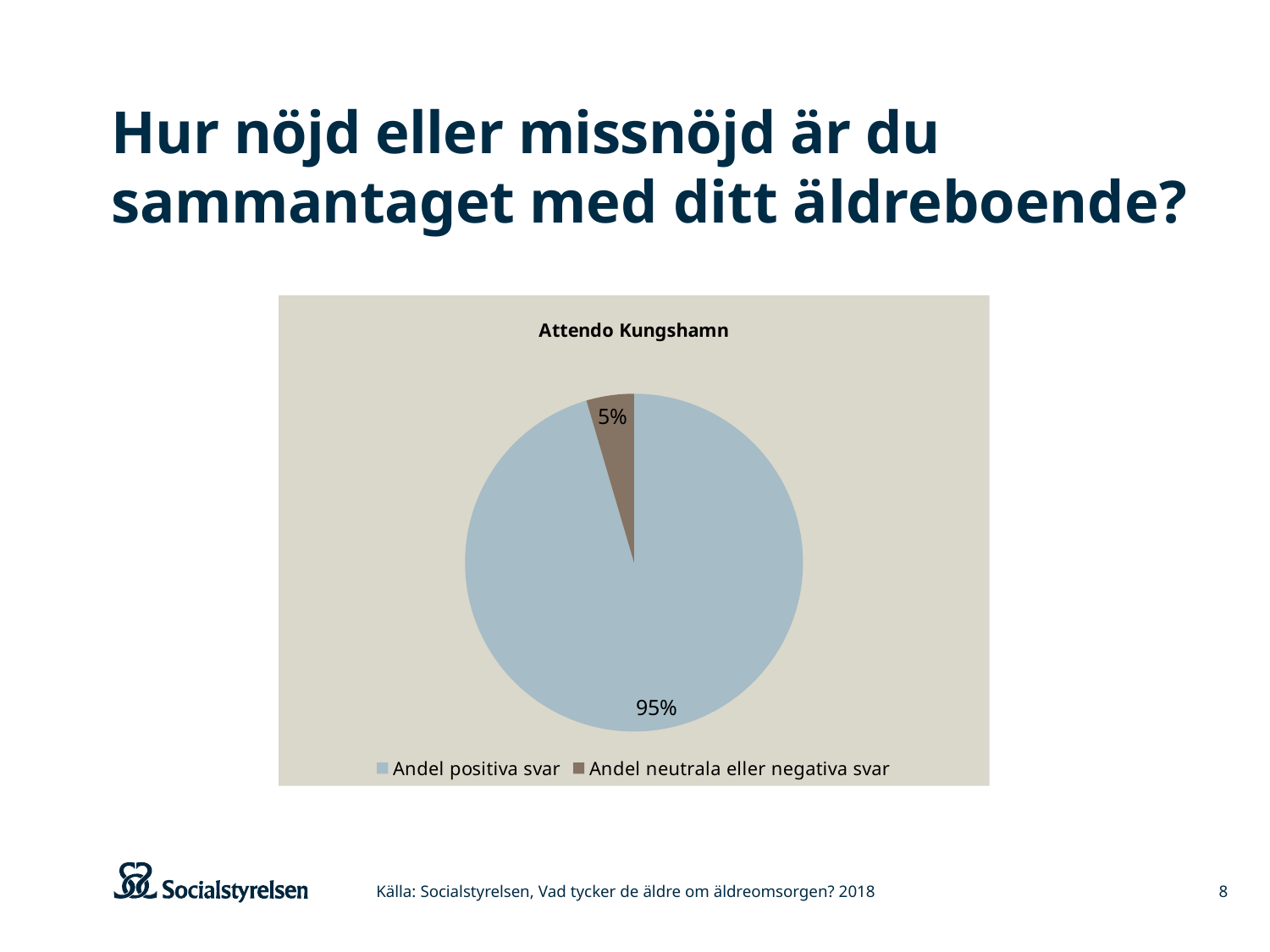
What share of the pie is 'Andel positiva svar'? 95% Which slice is the smallest in the pie chart? Andel neutrala eller negativa svar How many slices does the pie chart have? 2 What colour is the 'Andel neutrala eller negativa svar' slice? Brown What is the difference between the 'Andel positiva svar' share and the 'Andel neutrala eller negativa svar' share? 90% Which slice is the largest in the pie chart? Andel positiva svar What share of the pie is 'Andel neutrala eller negativa svar'? 5% How many entries does the legend list? 2 Which is larger: 'Andel positiva svar' or 'Andel neutrala eller negativa svar'? Andel positiva svar What type of chart is shown on the slide? Pie chart What is the title of the chart? Attendo Kungshamn